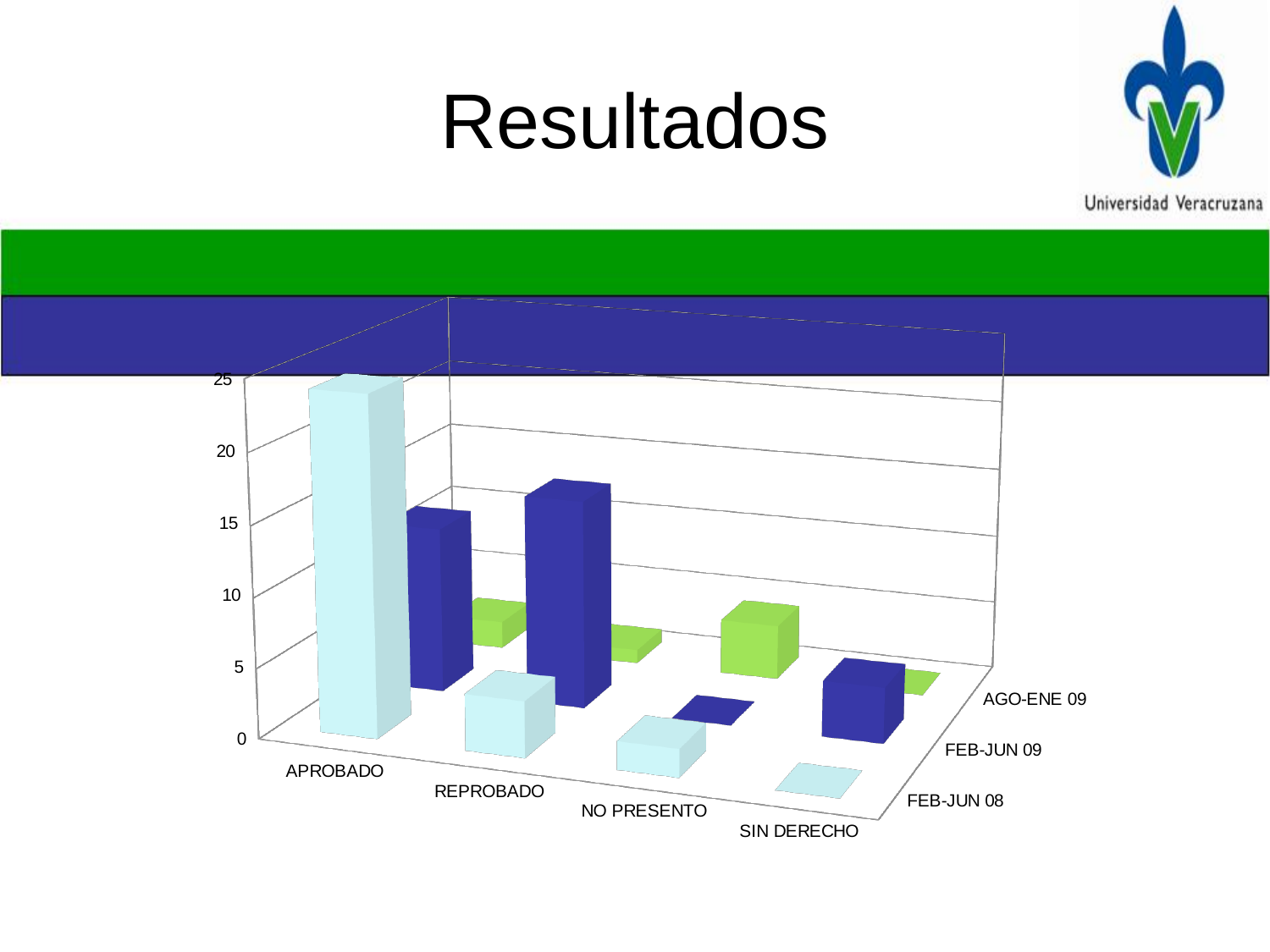
Is the value for SIN DERECHO in FEB-JUN 08 greater or less than 5? less Do the FEB-JUN 08 values rise or fall from APROBADO to SIN DERECHO? fall In AGO-ENE 09, which is larger, APROBADO or SIN DERECHO? APROBADO In FEB-JUN 08, which is larger, APROBADO or REPROBADO? APROBADO Which category has the tallest bar in the chart? APROBADO How many categories are shown along the x axis of the chart? 4 Is the value for NO PRESENTO in FEB-JUN 09 greater or less than 5? less How many periods (series) are plotted in the chart? 3 Is the value for APROBADO in FEB-JUN 08 greater or less than 20? greater What are the four category labels on the x axis of the chart? APROBADO, REPROBADO, NO PRESENTO, SIN DERECHO What kind of chart is shown on the slide? bar chart